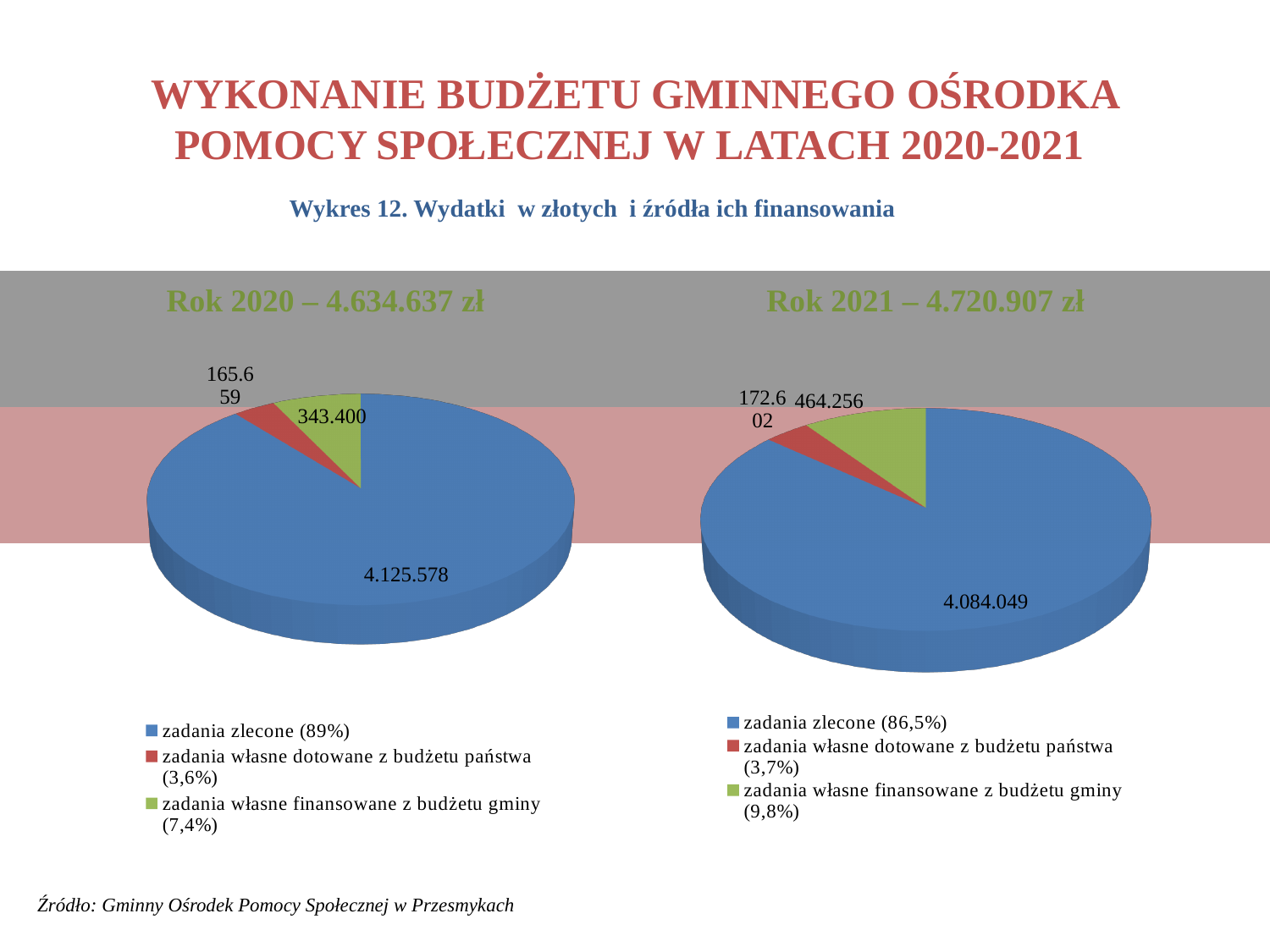
In the Rok 2021 pie chart, what share of the pie is zadania zlecone? 86,5% In the Rok 2021 pie chart, which category has the smallest slice? zadania własne dotowane z budżetu państwa How many categories does the legend of the Rok 2020 pie chart list? 3 In the Rok 2020 pie chart, what is the value for zadania zlecone? 4.125.578 What type of chart is used on this slide for Rok 2020 and Rok 2021? pie chart In the Rok 2020 pie chart, what is the value for zadania własne finansowane z budżetu gminy? 343.400 In the Rok 2021 pie chart, what is the value for zadania zlecone? 4.084.049 In the Rok 2020 pie chart, what share of the pie is zadania własne finansowane z budżetu gminy? 7,4% Which is larger: zadania własne finansowane z budżetu gminy in the Rok 2020 chart or in the Rok 2021 chart? Rok 2021 In the Rok 2020 pie chart, which category has the largest slice? zadania zlecone In the Rok 2021 pie chart, what is the value for zadania własne finansowane z budżetu gminy? 464.256 What is the total shown in the title of the Rok 2021 pie chart? 4.720.907 zł